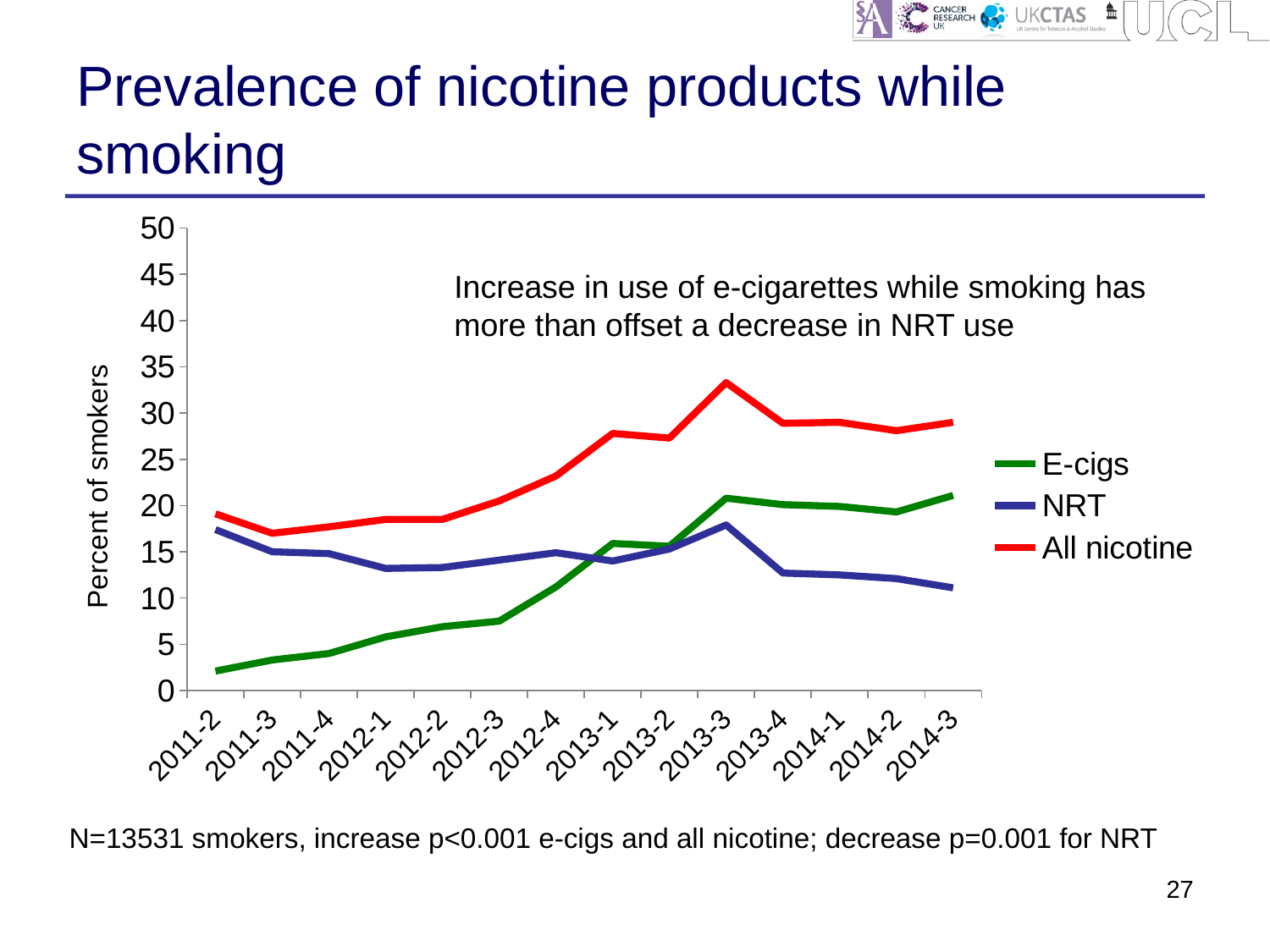
Do the E-cigs values generally rise or fall from 2011-2 to 2014-3? Rise Is the E-cigs value at 2011-2 greater or less than 5? less How many series does the legend list? 3 Is the NRT value at 2014-3 greater or less than 15? less What kind of chart is shown on the slide? Line chart At 2014-3, which is larger: the E-cigs value or the NRT value? E-cigs Is the All nicotine value at 2013-3 greater or less than 30? greater In which period does the All nicotine series reach its highest value? 2013-3 Do the NRT values generally rise or fall from 2011-2 to 2014-3? Fall In which period is the E-cigs value lowest? 2011-2 What is the label on the y axis? Percent of smokers How many time periods are plotted along the x axis? 14